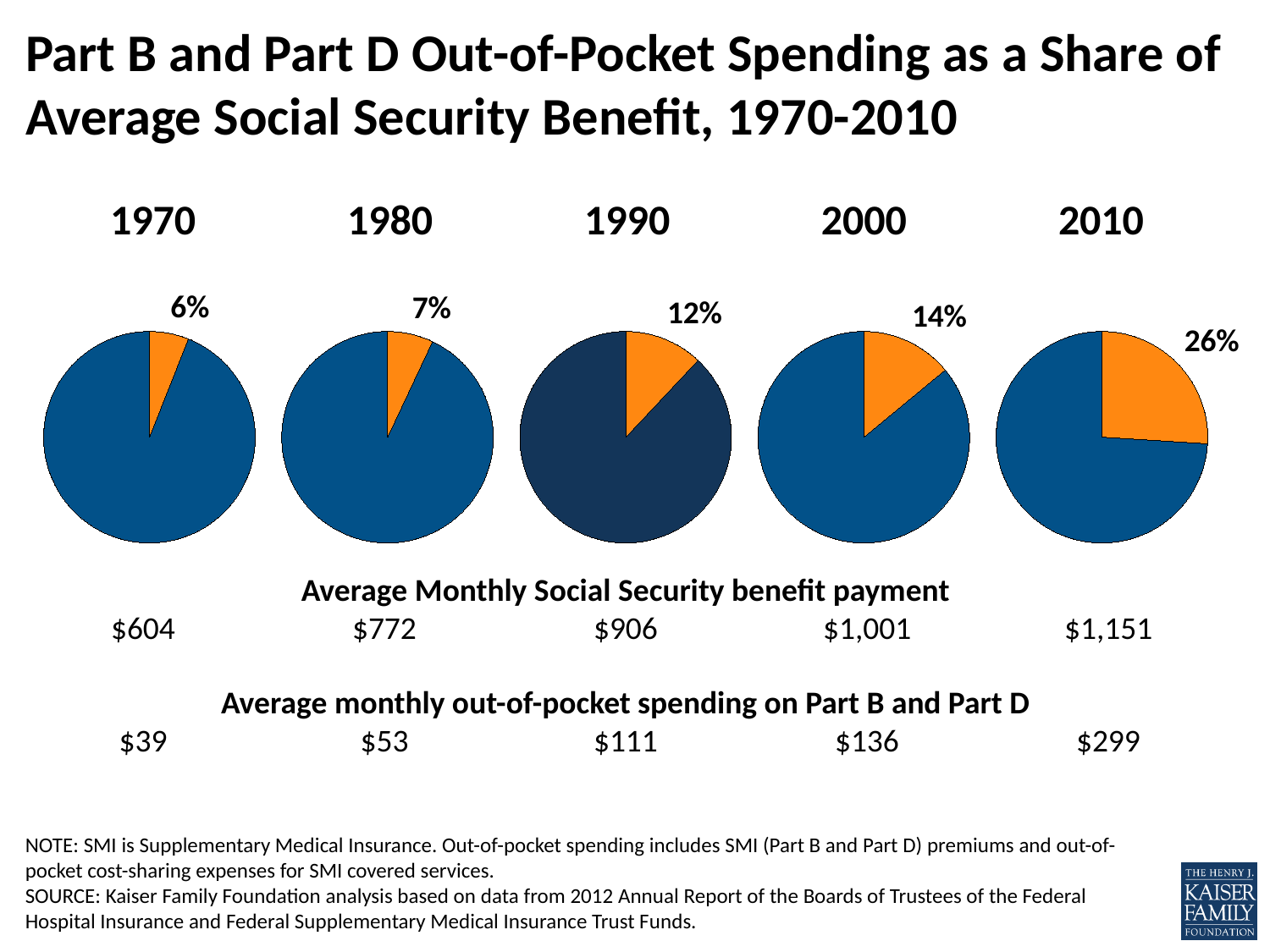
Which year's pie chart shows the largest out-of-pocket spending share? 2010 What kind of charts are shown on the slide? Pie charts Which is larger, the out-of-pocket share in 1980 or in 1990? 1990 What is the difference in percentage points between the out-of-pocket share in 2010 and in 2000? 12 percentage points How many pie charts are shown on the slide? 5 Does the out-of-pocket spending share rise or fall from 1970 to 2010 across the pie charts? Rise What was the average monthly Social Security benefit payment shown for 2000? $1,001 In the 1990 pie chart, what share of the average Social Security benefit is Part B and Part D out-of-pocket spending? 12% In the 2010 pie chart, what share of the average Social Security benefit is Part B and Part D out-of-pocket spending? 26% Which year's pie chart shows the smallest out-of-pocket spending share? 1970 In the 1970 pie chart, what share of the average Social Security benefit is Part B and Part D out-of-pocket spending? 6% What was the average monthly out-of-pocket spending on Part B and Part D shown for 1980? $53